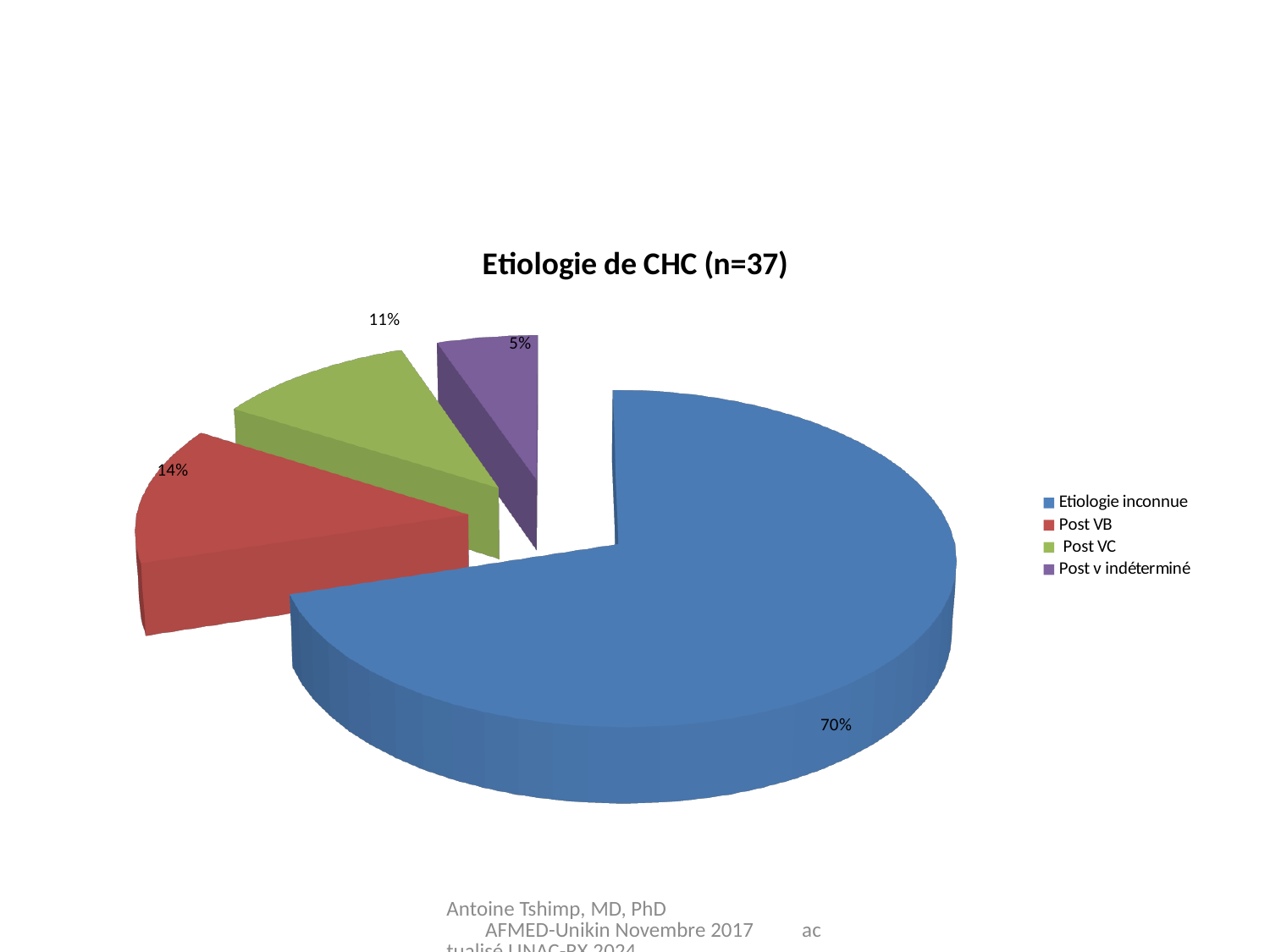
Which is larger, the share for Post VB or the share for Post VC? Post VB What share of the pie does Post VB represent? 14% What kind of chart is shown on the slide? Pie chart What is the title of the chart? Etiologie de CHC (n=37) What share of the pie does Etiologie inconnue represent? 70% What share of the pie does Post VC represent? 11% What is the difference in percentage points between Etiologie inconnue and Post VB? 56 How many categories does the legend list? 4 Which category has the smallest slice of the pie? Post v indéterminé Which category has the largest slice of the pie? Etiologie inconnue What colour is the slice for Post VC? Green